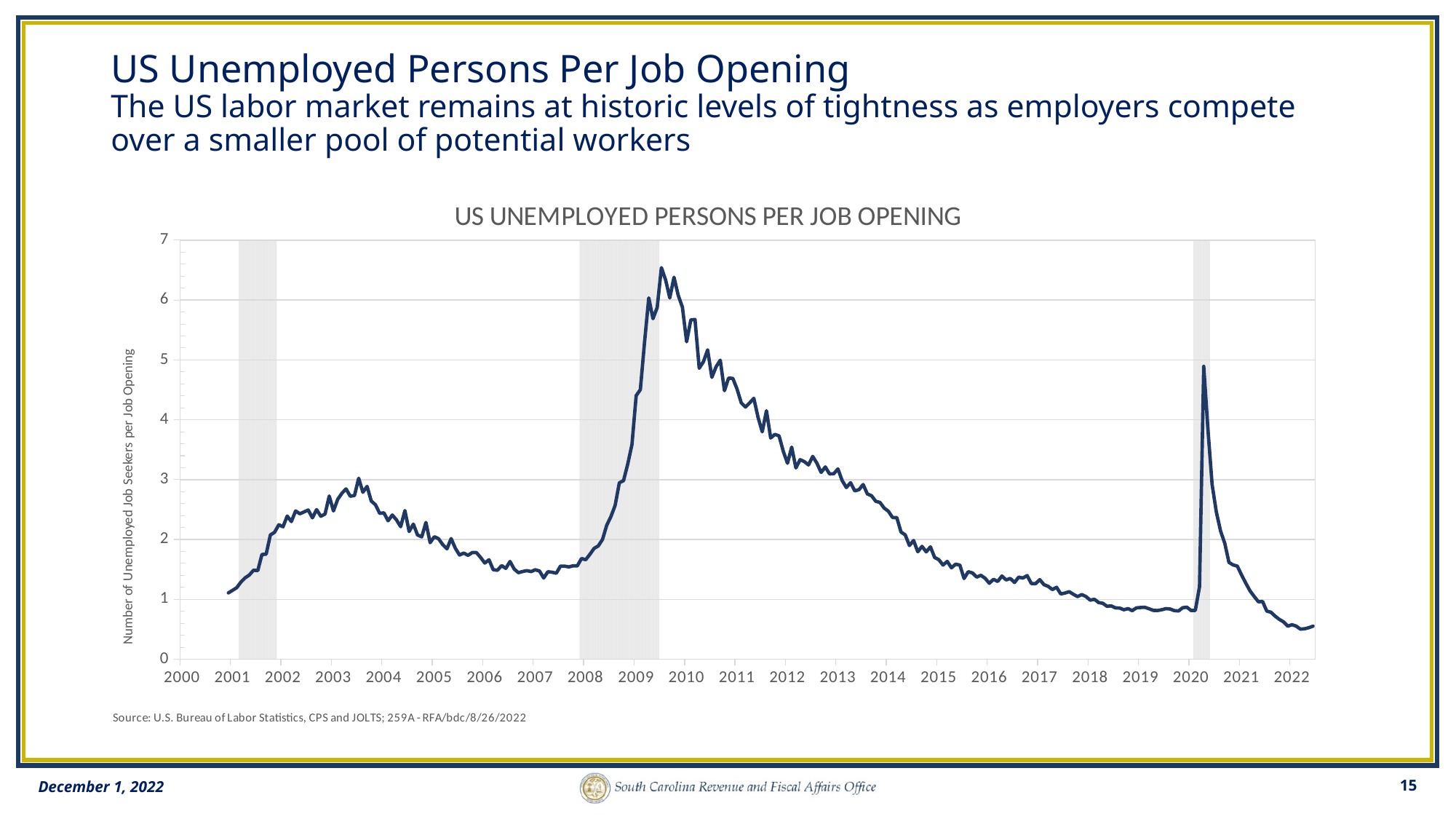
Is the peak value reached in 2009 greater or less than 6? greater Is the value during 2016 greater or less than 2? less What is the title of the chart? US UNEMPLOYED PERSONS PER JOB OPENING Between 2010 and 2019, does the line generally rise or fall? fall Between 2021 and 2022, does the line rise or fall? fall Is the value at the end of the line in 2022 greater or less than 1? less What is the label on the vertical axis of the chart? Number of Unemployed Job Seekers per Job Opening What kind of chart is shown on the slide? line chart In which year does the line reach its highest value? 2009